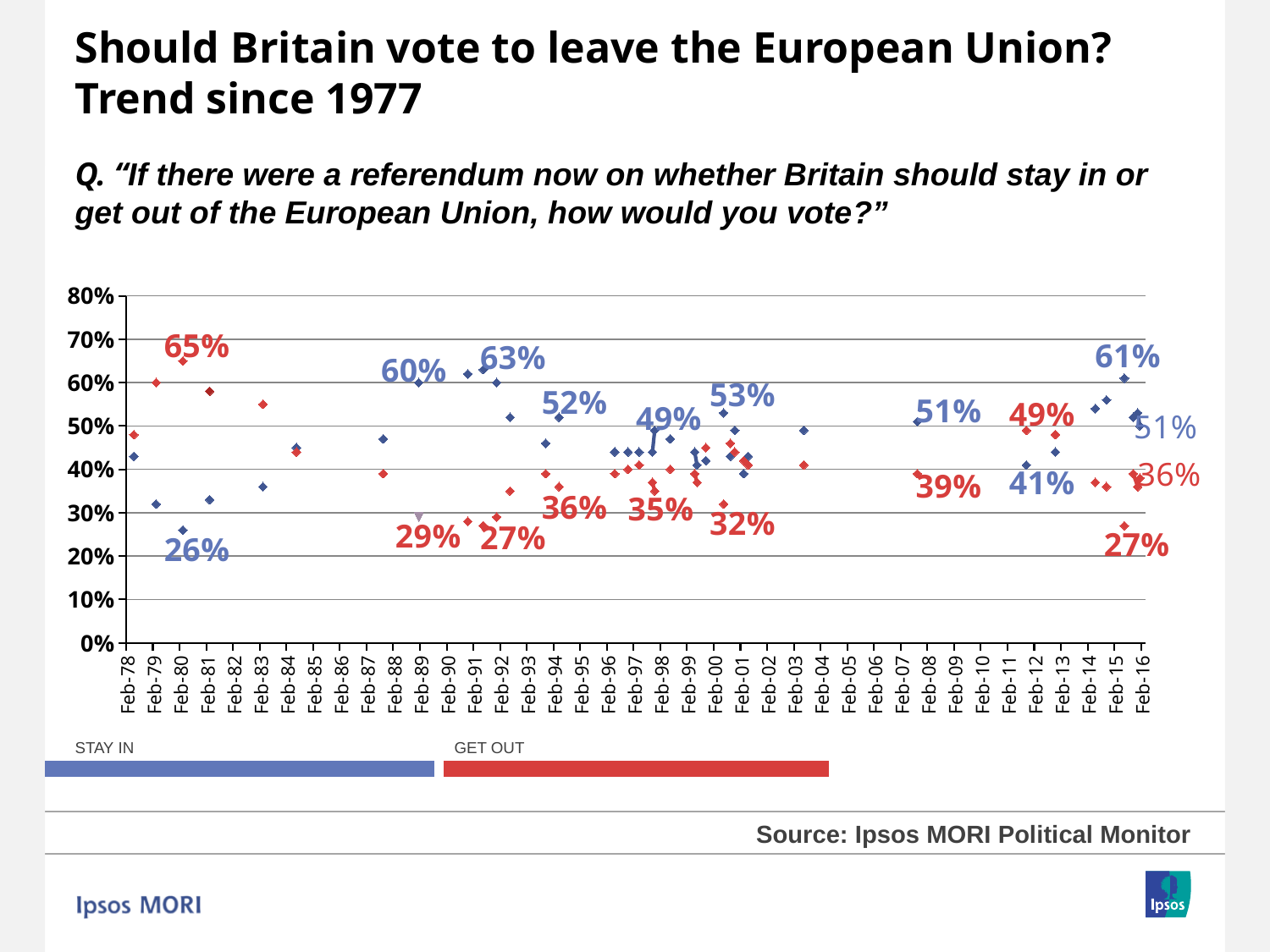
What kind of chart is shown on the slide? scatter chart Is the labelled GET OUT value at Feb-16 greater or less than 40%? less Which two series are shown in the legend? STAY IN and GET OUT What is the difference between the labelled STAY IN value (61%) and the labelled GET OUT value (27%) at Feb-15? 34 percentage points What is the highest labelled value for the GET OUT series? 65% Which colour represents the GET OUT series? red What is the lowest labelled value for the STAY IN series? 26% How many series does the legend list? 2 What is the labelled GET OUT value at Feb-15? 27% At Feb-12, which labelled value is larger: STAY IN (41%) or GET OUT (49%)? GET OUT What is the highest labelled value for the STAY IN series? 63% What is the labelled STAY IN value at Feb-15? 61%